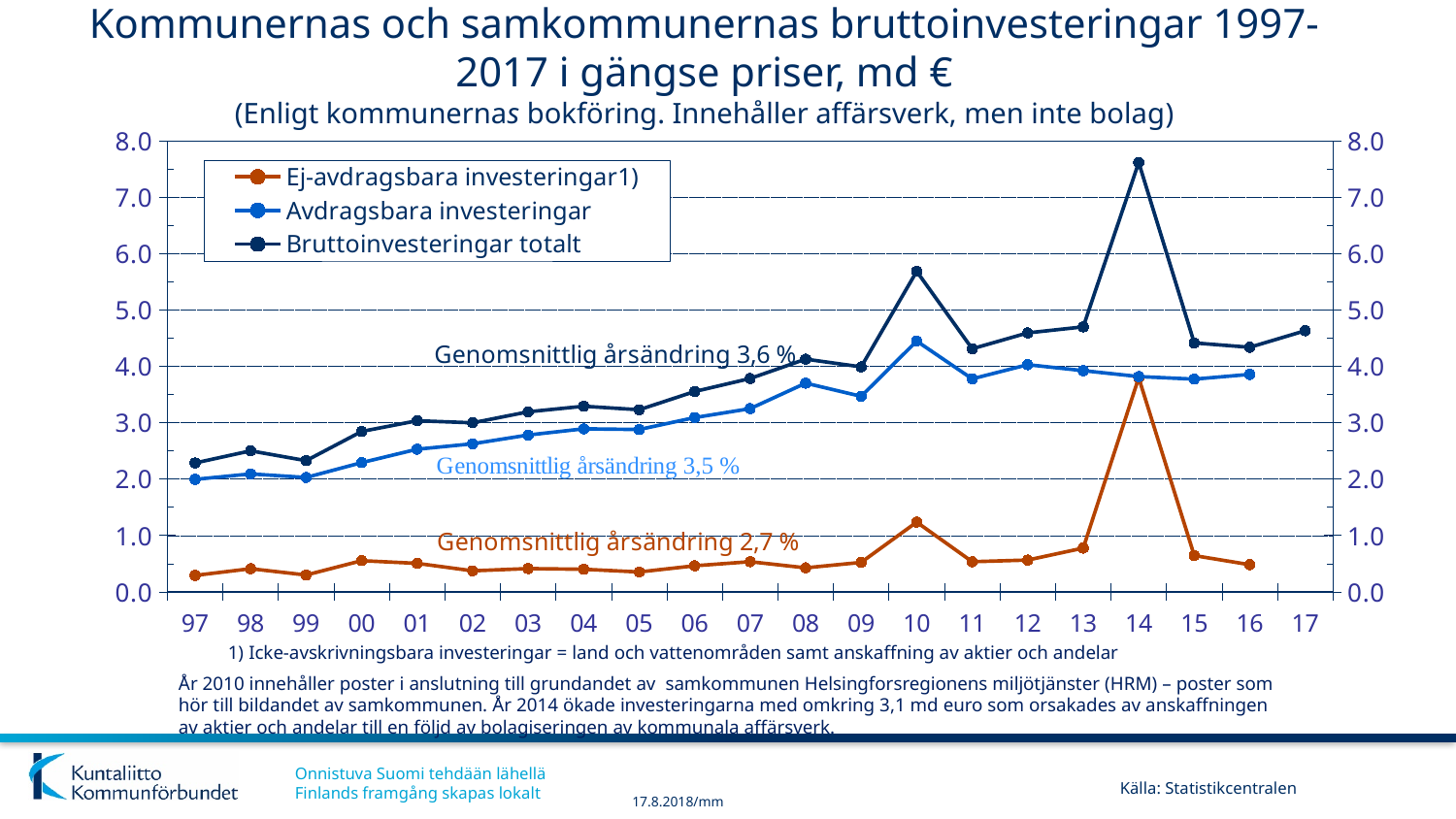
What average annual change (Genomsnittlig årsändring) is printed for Bruttoinvesteringar totalt? 3,6 % Is the value for Ej-avdragsbara investeringar in 97 greater or less than 1.0? less How many series does the legend list? 3 Is the value for Bruttoinvesteringar totalt in 10 greater or less than 5.0? greater In which year is Bruttoinvesteringar totalt highest? 14 In which year is Avdragsbara investeringar highest? 10 Is the value for Bruttoinvesteringar totalt in 14 greater or less than 7.0? greater In which year is Ej-avdragsbara investeringar highest? 14 What kind of chart is shown on the slide? line chart Does Avdragsbara investeringar rise or fall from 97 to 08? rise Which is larger for Bruttoinvesteringar totalt: the value in 10 or the value in 14? 14 How many years are shown on the x axis? 21